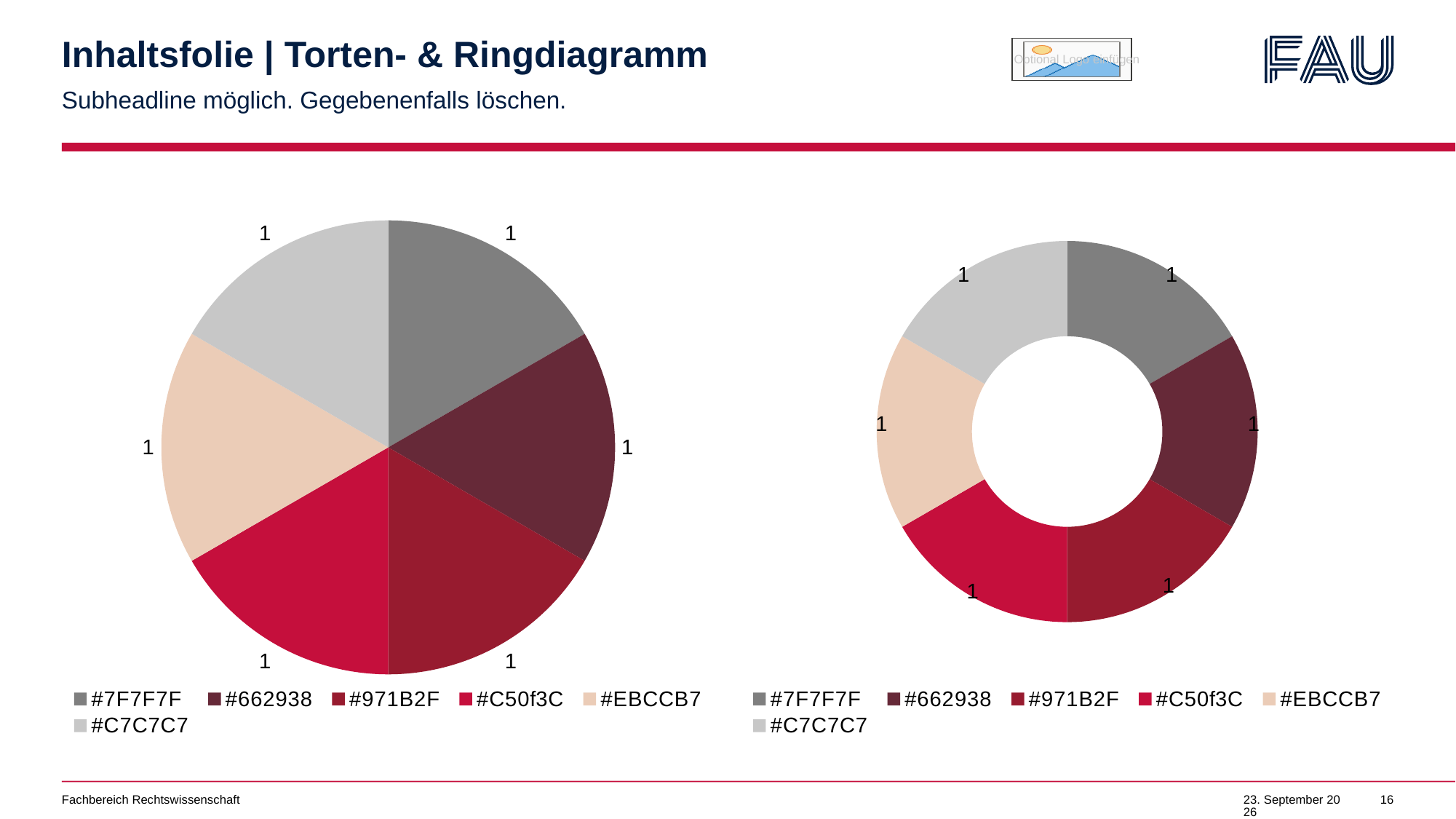
In the pie chart on the left, which legend entry corresponds to the lightest grey slice? #C7C7C7 In the doughnut chart on the right, what is the total of all segment values? 6 In the pie chart on the left, what is the value of the #7F7F7F slice? 1 In the pie chart on the left, what is the value of the #C50f3C slice? 1 How many entries does the legend of the doughnut chart on the right list? 6 In the pie chart on the left, what is the difference between the values of the #662938 slice and the #C7C7C7 slice? 0 What kind of chart is the chart on the right side of the slide? doughnut chart What kind of chart is the chart on the left side of the slide? pie chart In the doughnut chart on the right, what is the value of the #EBCCB7 segment? 1 In the pie chart on the left, how many slices are there? 6 In the pie chart on the left, what is the total of all slice values? 6 In the doughnut chart on the right, how many segments are there? 6